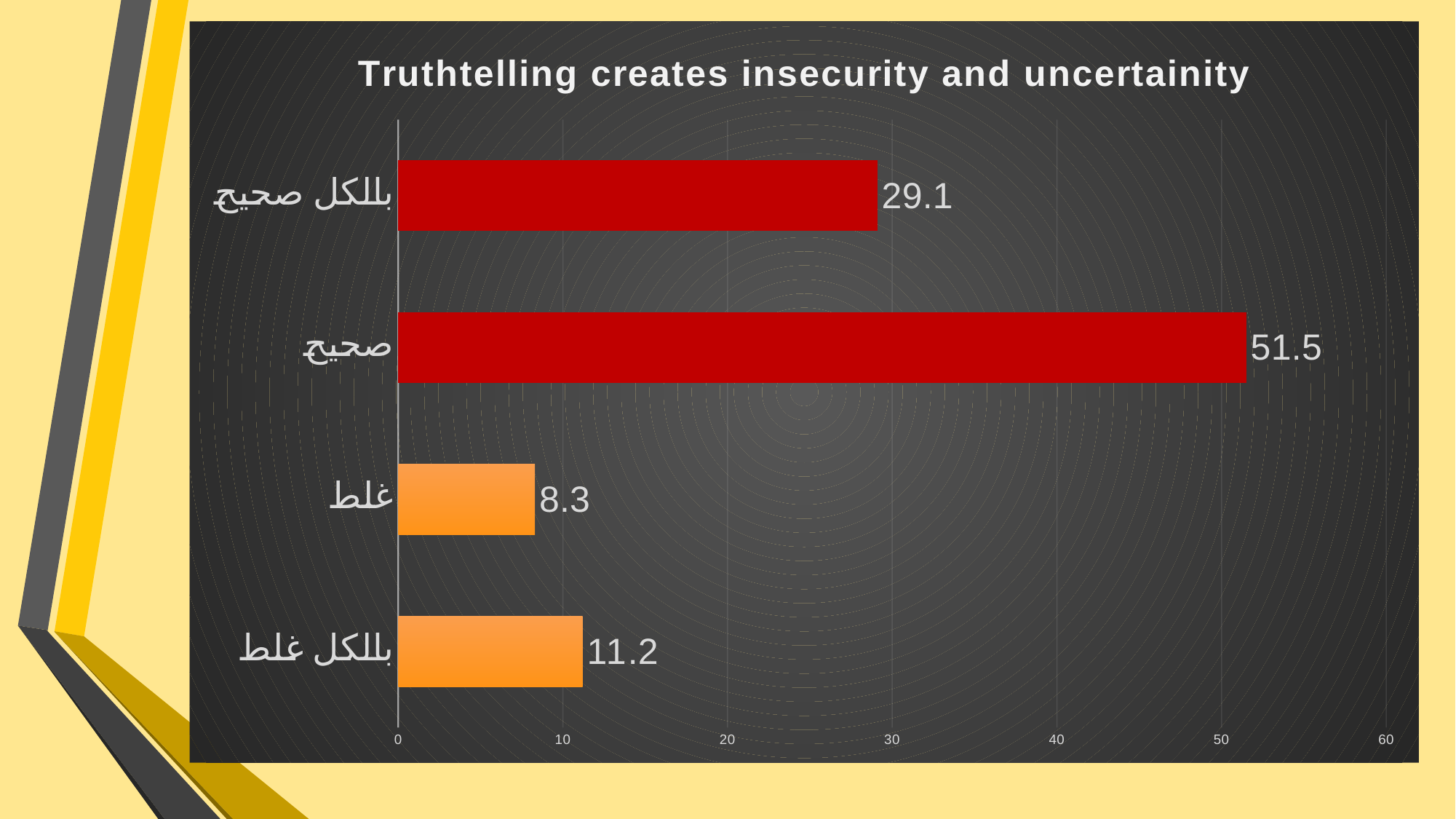
What is the value for "صحيح"? 51.5 What type of chart is shown on the slide? Bar chart What is the value for "غلط"? 8.3 Which category has the highest value? صحیح What is the value for "بالكل صحيح"? 29.1 What is the difference between the values for "بالكل غلط" and "غلط"? 2.9 How many categories are shown in the chart? 4 Is the value for "صحيح" greater or less than 50? greater Which is larger, the value for "بالكل صحيح" or the value for "بالكل غلط"? بالکل صحیح What is the value for "بالكل غلط"? 11.2 What is the difference between the values for "صحيح" and "بالكل صحيح"? 22.4 Which category has the lowest value? غلط